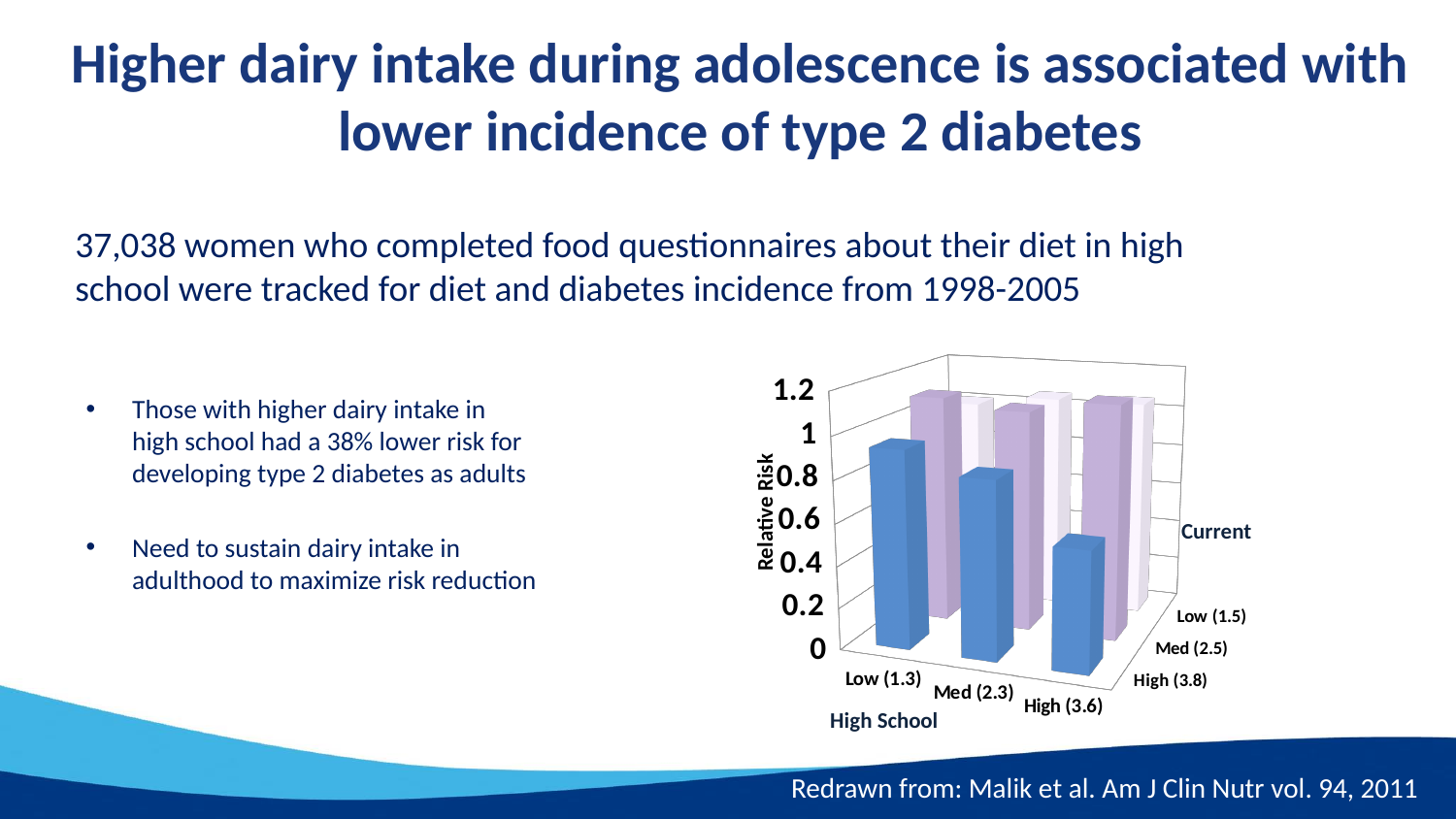
Is the relative risk for the blue front-row bar at High School High (3.6) greater or less than 0.8? less Among the blue bars in the front row, which High School category has the lowest relative risk? High (3.6) Do the blue front-row bars rise or fall as High School dairy intake goes from Low (1.3) to High (3.6)? fall How many High School dairy intake categories are shown along the front axis of the chart? 3 Among the blue bars in the front row, which High School category has the highest relative risk? Low (1.3) What is the highest value shown on the Relative Risk axis? 1.2 What kind of chart is shown on the slide? bar chart What label is given to the depth axis of the chart? Current Is the relative risk for the blue front-row bar at High School Low (1.3) greater or less than 0.6? greater How many Current dairy intake categories are shown along the depth axis of the chart? 3 What is the title of the vertical axis of the chart? Relative Risk Which is larger for the blue front-row bars: the relative risk at High School Med (2.3) or at High School High (3.6)? Med (2.3)